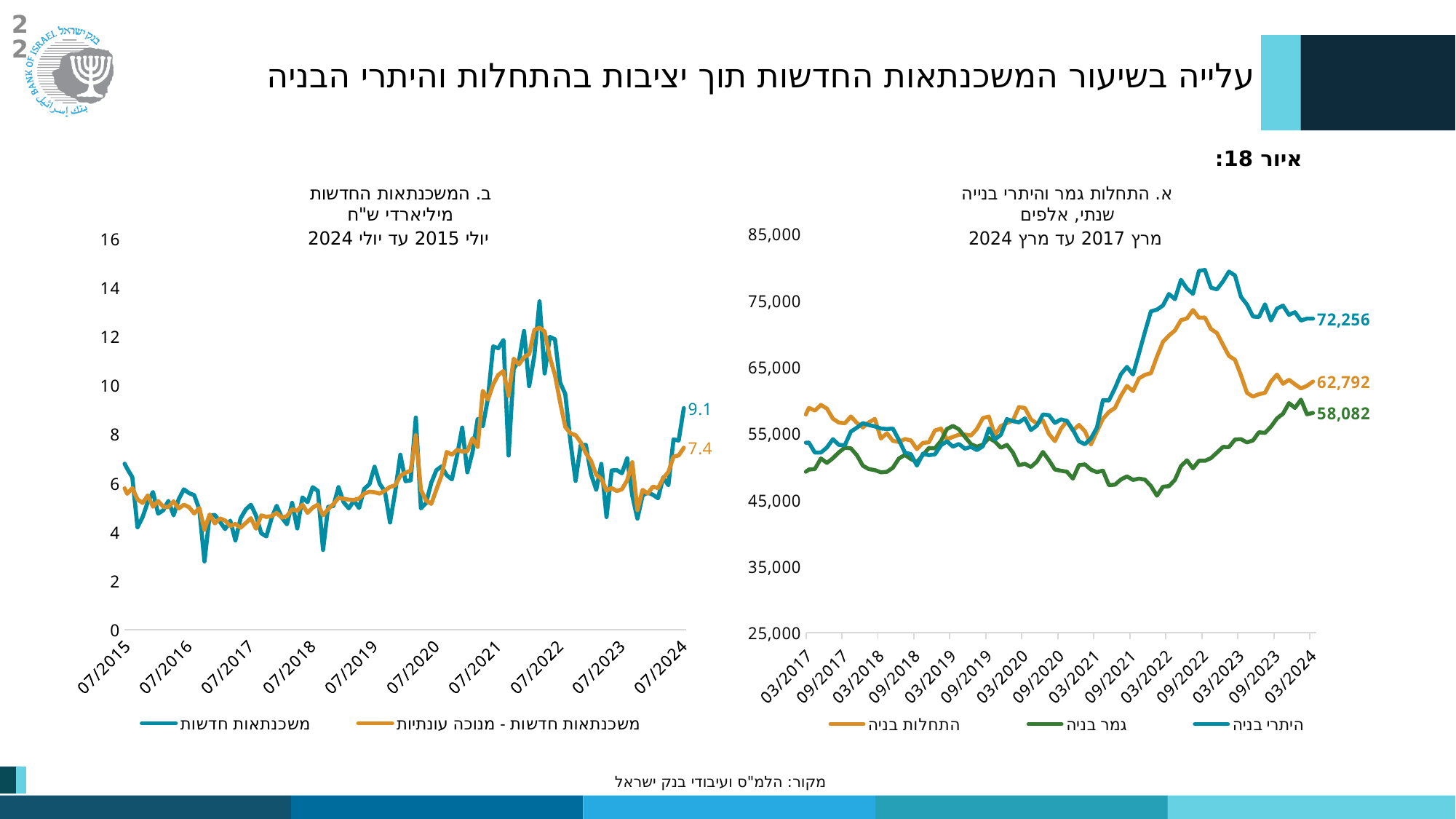
What kind of chart is the left chart (ב. המשכנתאות החדשות)? Line chart In the right chart (א. התחלות גמר והיתרי בנייה), what is the difference between the final labelled values of היתרי בניה and גמר בניה? 14,174 In the right chart (א. התחלות גמר והיתרי בנייה), what is the final labelled value for היתרי בניה? 72,256 In the left chart (ב. המשכנתאות החדשות), what is the final labelled value for משכנתאות חדשות? 9.1 In the right chart (א. התחלות גמר והיתרי בנייה), what is the final labelled value for התחלות בניה? 62,792 In the left chart (ב. המשכנתאות החדשות), what is the final labelled value for משכנתאות חדשות - מנוכה עונתיות? 7.4 In the left chart (ב. המשכנתאות החדשות), how many series does the legend list? 2 In the right chart (א. התחלות גמר והיתרי בנייה), how many series does the legend list? 3 In the left chart (ב. המשכנתאות החדשות), what is the difference between the final labelled values of the two series? 1.7 In the right chart (א. התחלות גמר והיתרי בנייה), what is the final labelled value for גמר בניה? 58,082 In the right chart (א. התחלות גמר והיתרי בנייה), which series has the highest final labelled value? היתרי בניה In the right chart (א. התחלות גמר והיתרי בנייה), is the final value for גמר בניה greater or less than 55,000? greater